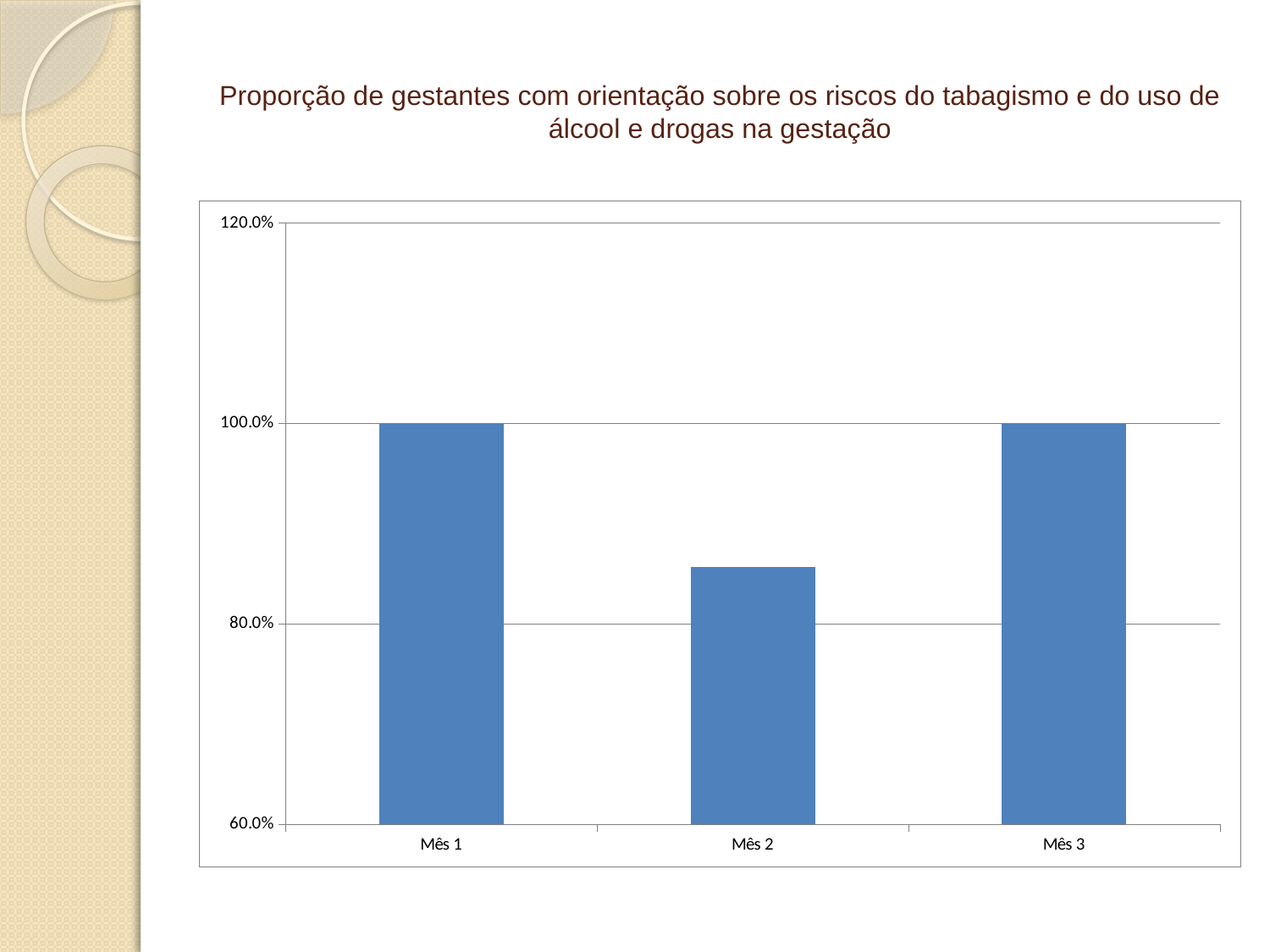
What is the title of the chart? Proporção de gestantes com orientação sobre os riscos do tabagismo e do uso de álcool e drogas na gestação Does the value rise or fall from Mês 2 to Mês 3? rise What is the value for Mês 1? 100.0% What kind of chart is shown on the slide? bar chart Is the value for Mês 2 greater or less than 100.0%? less What is the value for Mês 3? 100.0% How many categories are shown on the x axis? 3 Which month has the lowest value? Mês 2 What is the lowest value shown on the y axis? 60.0% Which is larger, the value for Mês 1 or the value for Mês 2? Mês 1 Which is larger, the value for Mês 2 or the value for Mês 3? Mês 3 Is the value for Mês 2 greater or less than 80.0%? greater